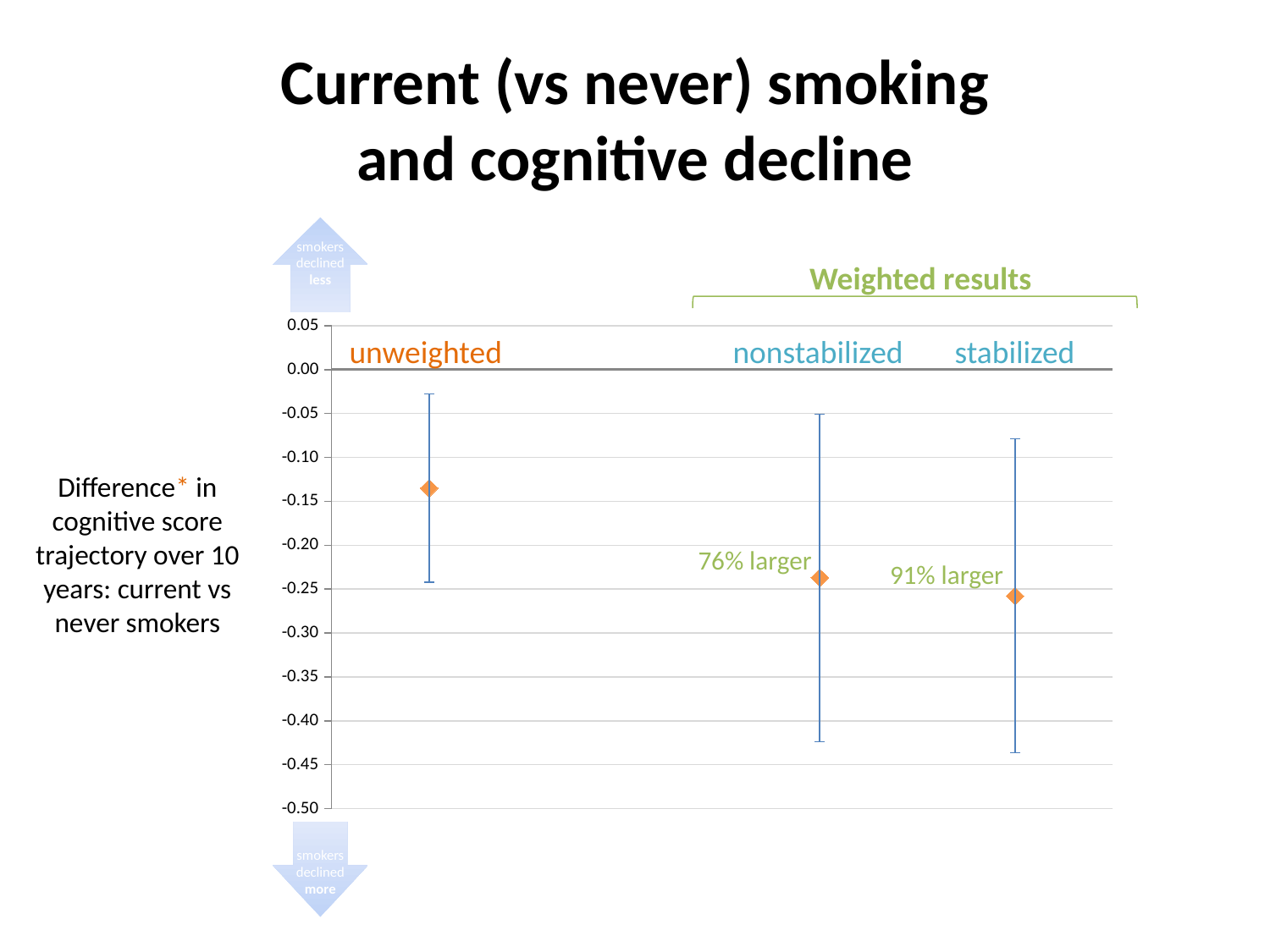
How many data points (categories) are plotted on the chart? 3 What kind of chart is shown on the slide? Scatter (point) chart with error bars Is the point estimate for nonstabilized greater or less than -0.20? less Do the point estimates rise or fall moving from unweighted to nonstabilized to stabilized? fall Which category has the lowest (most negative) point estimate? stabilized Which has the larger (less negative) point estimate, unweighted or stabilized? unweighted What label is printed next to the nonstabilized point? 76% larger Is the point estimate for unweighted greater or less than -0.10? less Is the point estimate for stabilized greater or less than -0.30? greater What label is printed next to the stabilized point? 91% larger Which two categories are grouped under the heading 'Weighted results'? nonstabilized and stabilized Which category has the highest (least negative) point estimate? unweighted